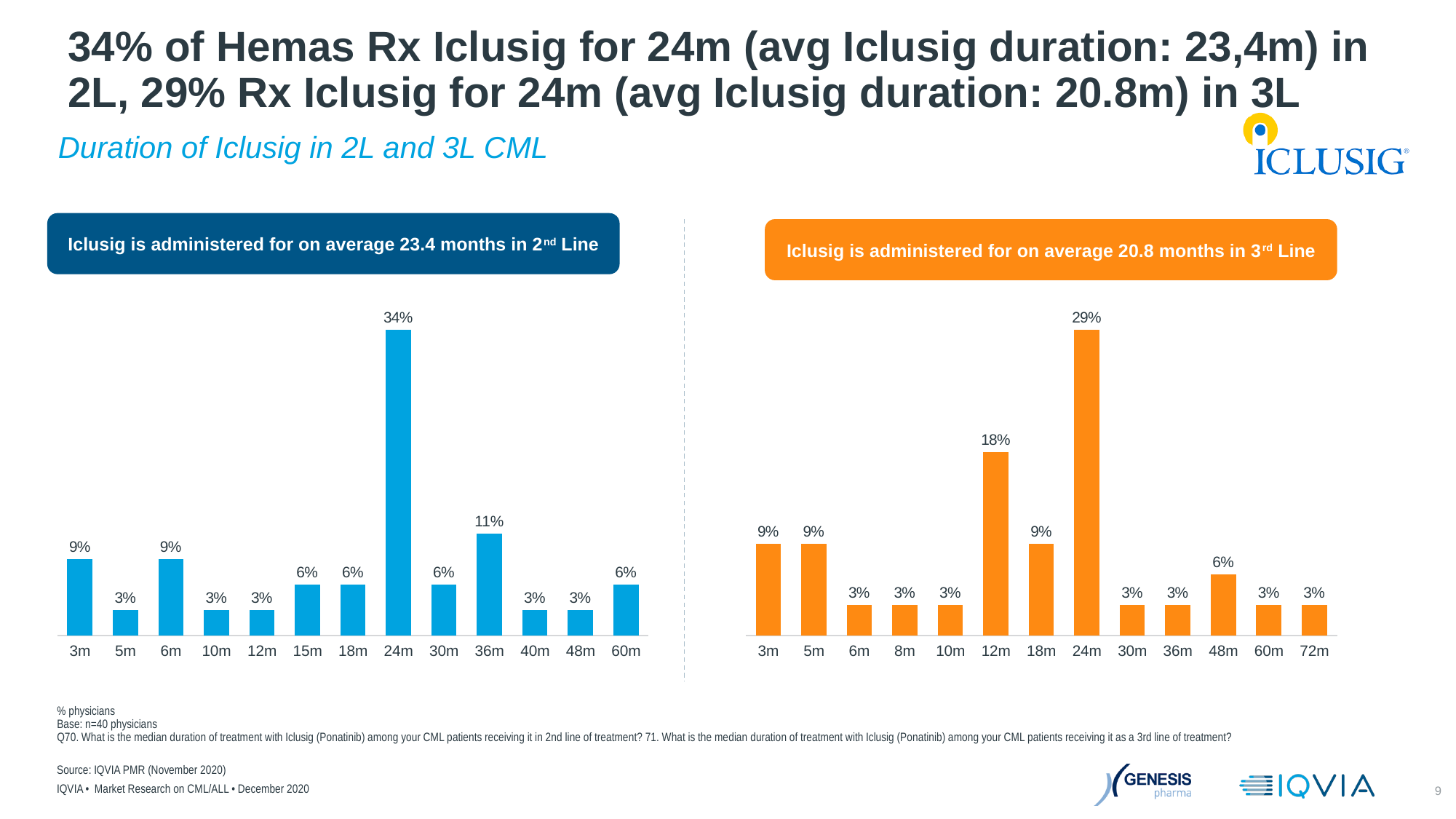
In the right chart (3rd Line), what is the value for 48m? 6% In the left chart (2nd Line), what is the value for 36m? 11% In the right chart (3rd Line), which duration has the highest percentage? 24m How many duration categories are shown in the left chart (2nd Line)? 13 What type of chart is used on the right side of the slide (3rd Line)? Bar chart In the left chart (2nd Line), what is the difference between the values for 24m and 36m? 23% In the right chart (3rd Line), which is larger, the value for 18m or the value for 12m? 12m What colour are the bars in the left chart (2nd Line)? Blue In the left chart (2nd Line), which duration has the highest percentage? 24m In the right chart (3rd Line), what is the difference between the values for 24m and 12m? 11% In the right chart (3rd Line), what percentage of physicians prescribe Iclusig for 12m? 18% In the left chart (2nd Line), what percentage of physicians prescribe Iclusig for 24m? 34%